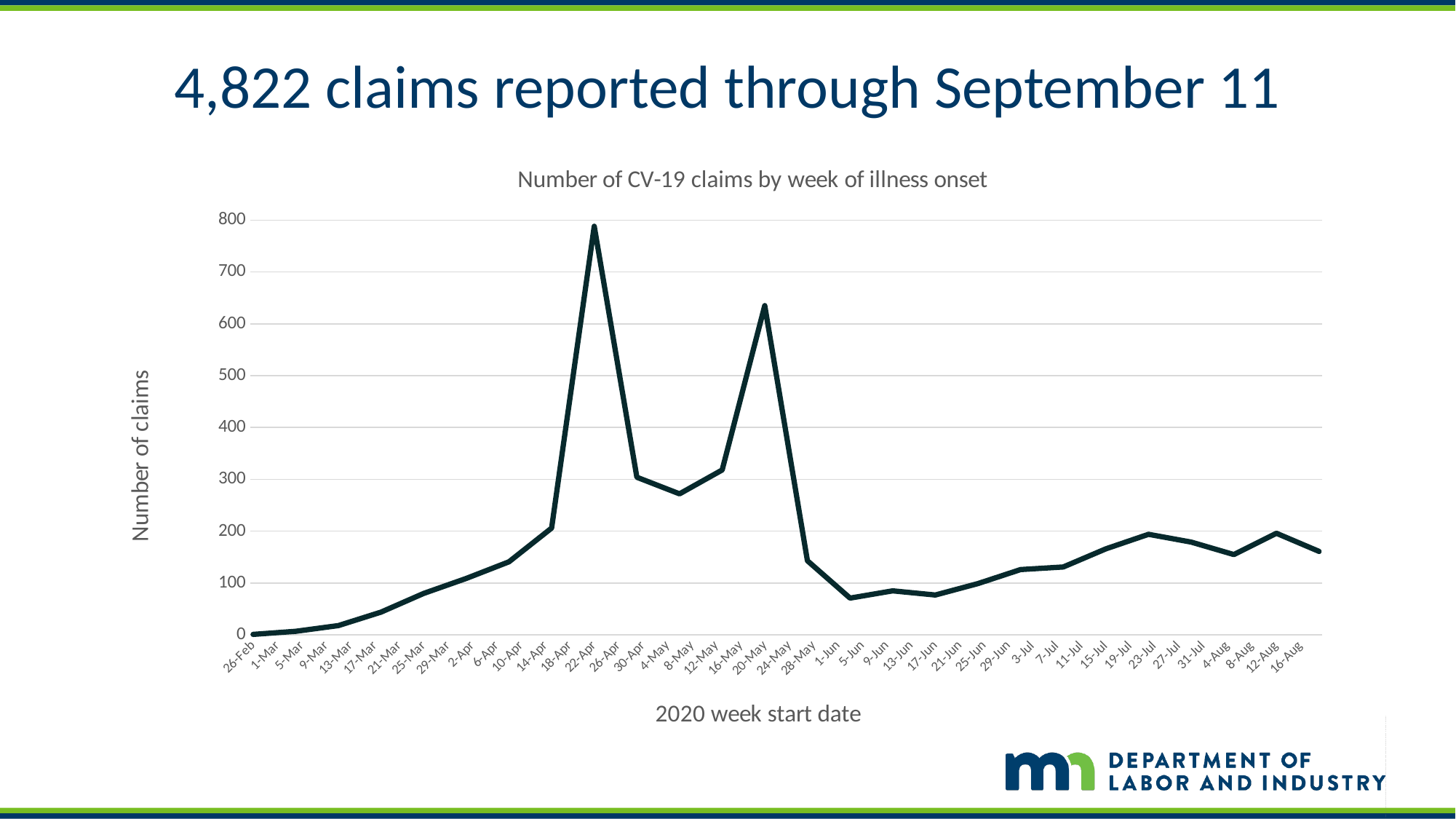
Which week start date has the highest number of claims? 22-Apr What is the title of the chart? Number of CV-19 claims by week of illness onset Is the value for 22-Apr greater or less than 700? greater What is the label of the vertical axis? Number of claims Is the value for 8-May greater or less than 300? less How many week start dates are plotted on the x axis? 44 Which has more claims, 22-Apr or 20-May? 22-Apr What kind of chart is shown on the slide? line chart Do the values rise or fall from 26-Feb to 22-Apr? rise Which has more claims, 23-Jul or 4-Aug? 23-Jul Is the value for 20-May greater or less than 600? greater